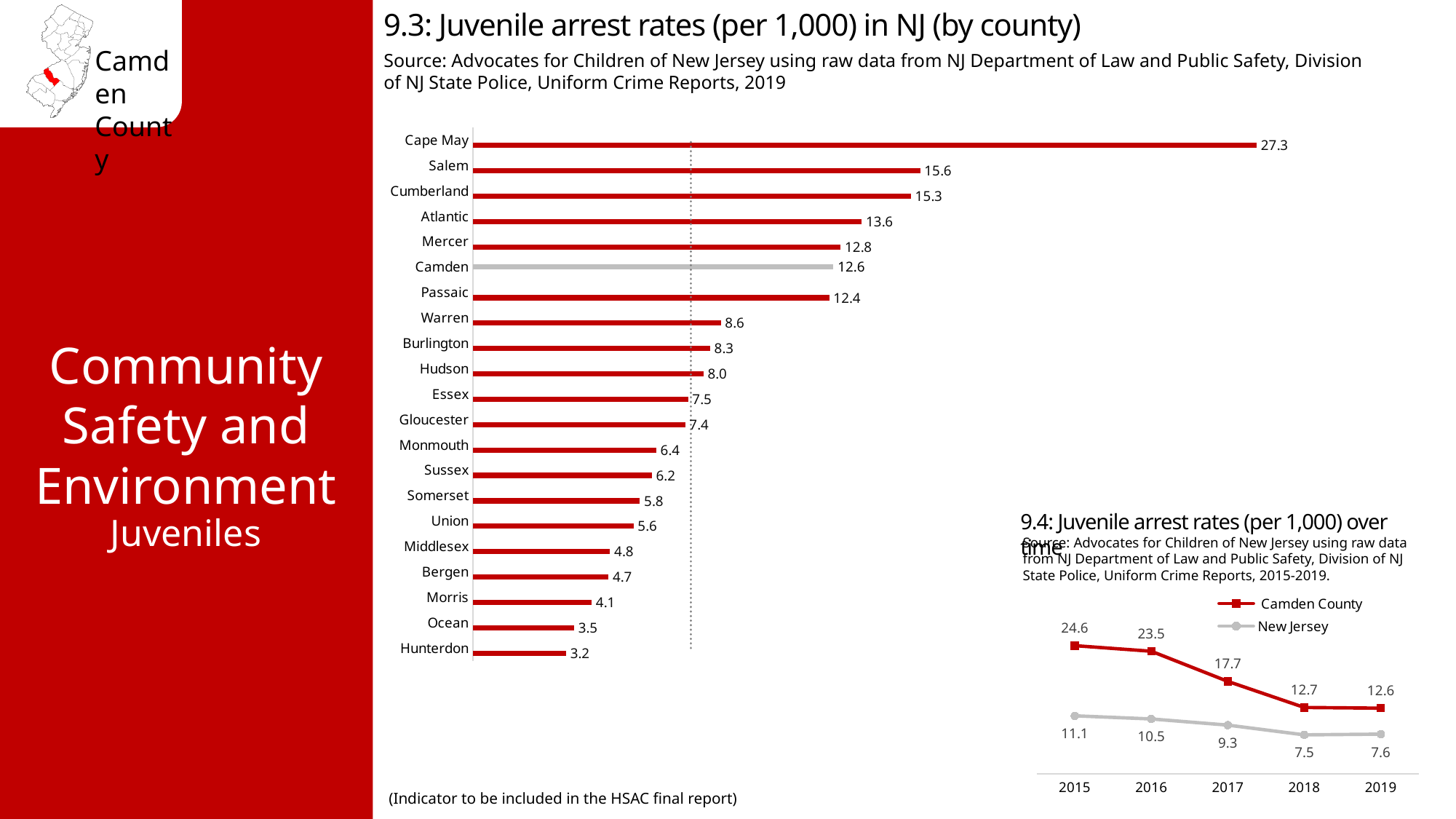
In the chart '9.3: Juvenile arrest rates (per 1,000) in NJ (by county)', which has a higher rate, Mercer or Passaic? Mercer In the chart '9.3: Juvenile arrest rates (per 1,000) in NJ (by county)', how many counties are shown? 21 In the chart '9.4: Juvenile arrest rates (per 1,000) over time', how many series does the legend list? 2 In the chart '9.4: Juvenile arrest rates (per 1,000) over time', what is the New Jersey value for 2018? 7.5 In the chart '9.3: Juvenile arrest rates (per 1,000) in NJ (by county)', which county has the highest rate? Cape May In the chart '9.3: Juvenile arrest rates (per 1,000) in NJ (by county)', what is the difference between the values for Cape May and Salem? 11.7 In the chart '9.4: Juvenile arrest rates (per 1,000) over time', what is the Camden County value for 2017? 17.7 What kind of chart is '9.3: Juvenile arrest rates (per 1,000) in NJ (by county)'? Bar chart In the chart '9.4: Juvenile arrest rates (per 1,000) over time', does the Camden County rate rise or fall from 2015 to 2019? Fall In the chart '9.3: Juvenile arrest rates (per 1,000) in NJ (by county)', which county has the lowest rate? Hunterdon In the chart '9.4: Juvenile arrest rates (per 1,000) over time', what is the difference between Camden County and New Jersey in 2015? 13.5 In the chart '9.3: Juvenile arrest rates (per 1,000) in NJ (by county)', what is the value for Camden? 12.6